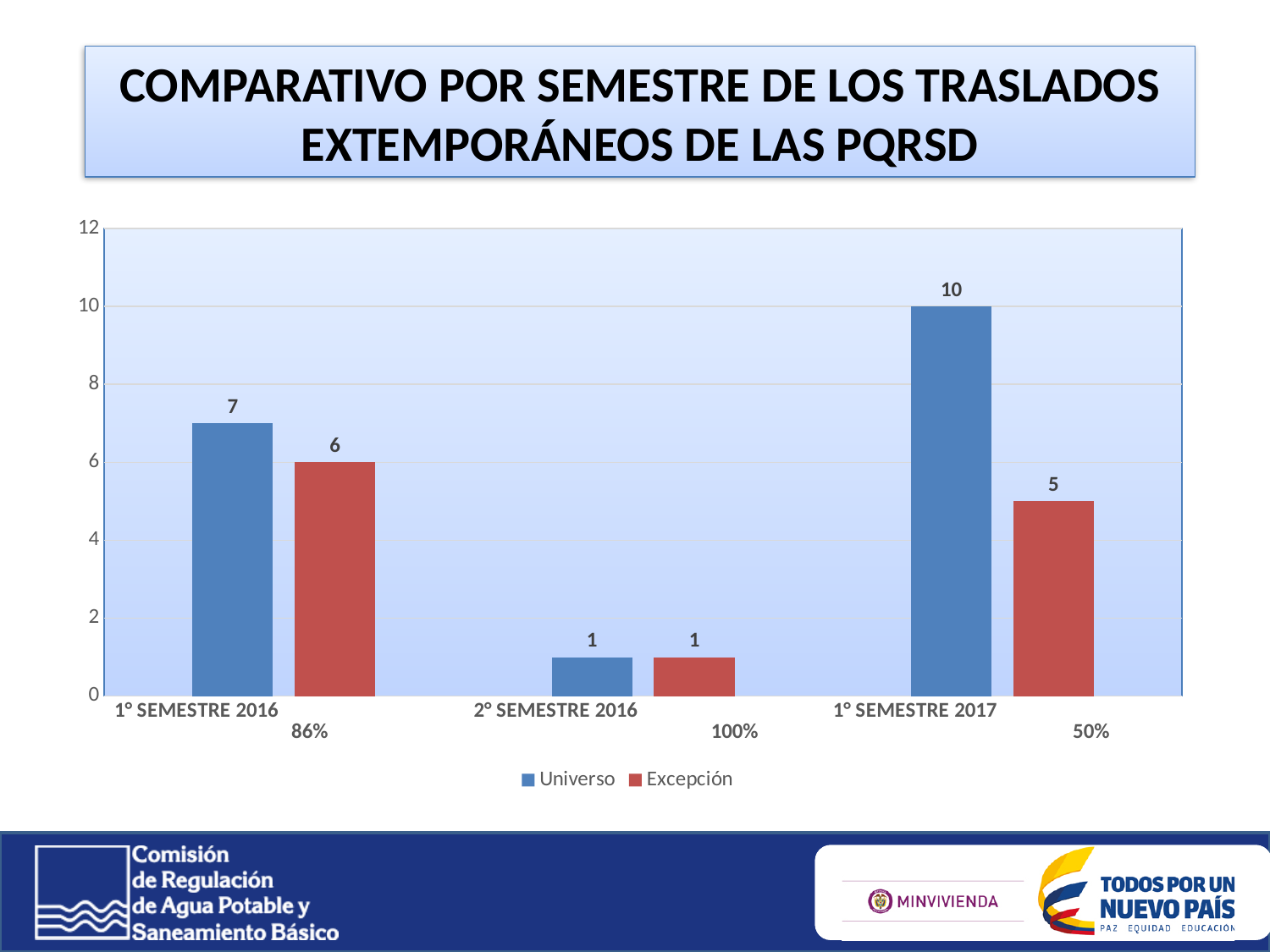
What kind of chart is shown on the slide? Bar chart Which semester has the highest Universo value? 1° SEMESTRE 2017 What is the Universo value for 1° SEMESTRE 2016? 7 What colour are the Excepción bars? Red What is the Excepción value for 2° SEMESTRE 2016? 1 What percentage is shown below the 1° SEMESTRE 2016 bars? 86% Which semester has the lowest Excepción value? 2° SEMESTRE 2016 What is the Excepción value for 1° SEMESTRE 2017? 5 How many series does the legend list? 2 Which is larger for 1° SEMESTRE 2016: Universo or Excepción? Universo How many semesters are shown on the x axis? 3 What is the difference between the Universo and Excepción values for 1° SEMESTRE 2017? 5